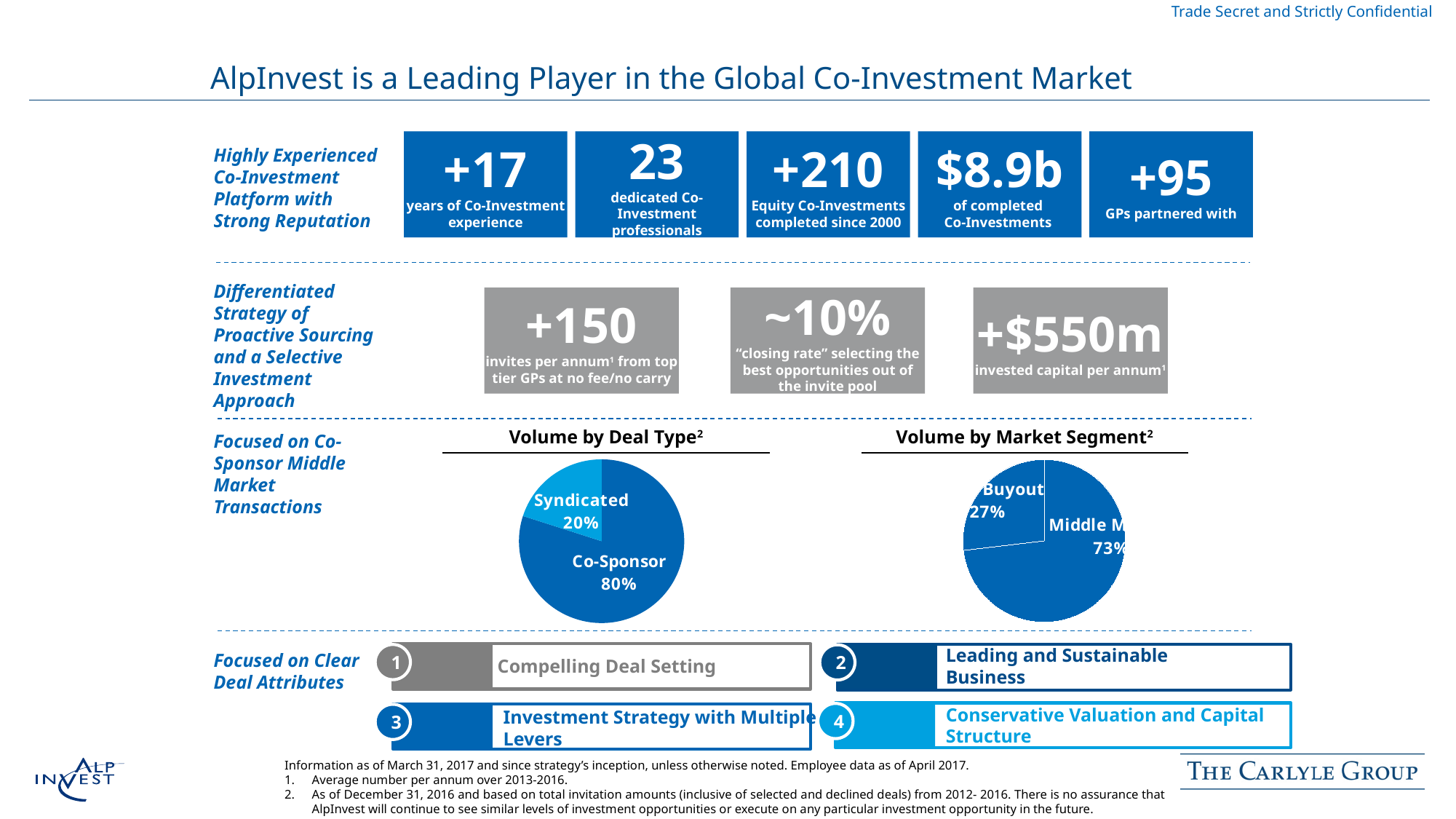
In the Volume by Deal Type chart, what is the difference in percentage points between the Co-Sponsor and Syndicated shares? 60 percentage points In the Volume by Deal Type chart, which deal type has the largest share? Co-Sponsor What kind of chart is the Volume by Market Segment chart? Pie chart What is the title of the pie chart on the left? Volume by Deal Type In the Volume by Market Segment chart, what share of volume is Buyout? 27% In the Volume by Deal Type chart, which deal type has the smallest share? Syndicated In the Volume by Deal Type chart, what share of volume is Co-Sponsor? 80% In the Volume by Deal Type chart, how many slices does the pie have? 2 In the Volume by Market Segment chart, is the Buyout slice the larger or the smaller of the two slices? Smaller In the Volume by Deal Type chart, what share of volume is Syndicated? 20% How many pie charts are shown on the slide? 2 What kind of chart is the Volume by Deal Type chart? Pie chart